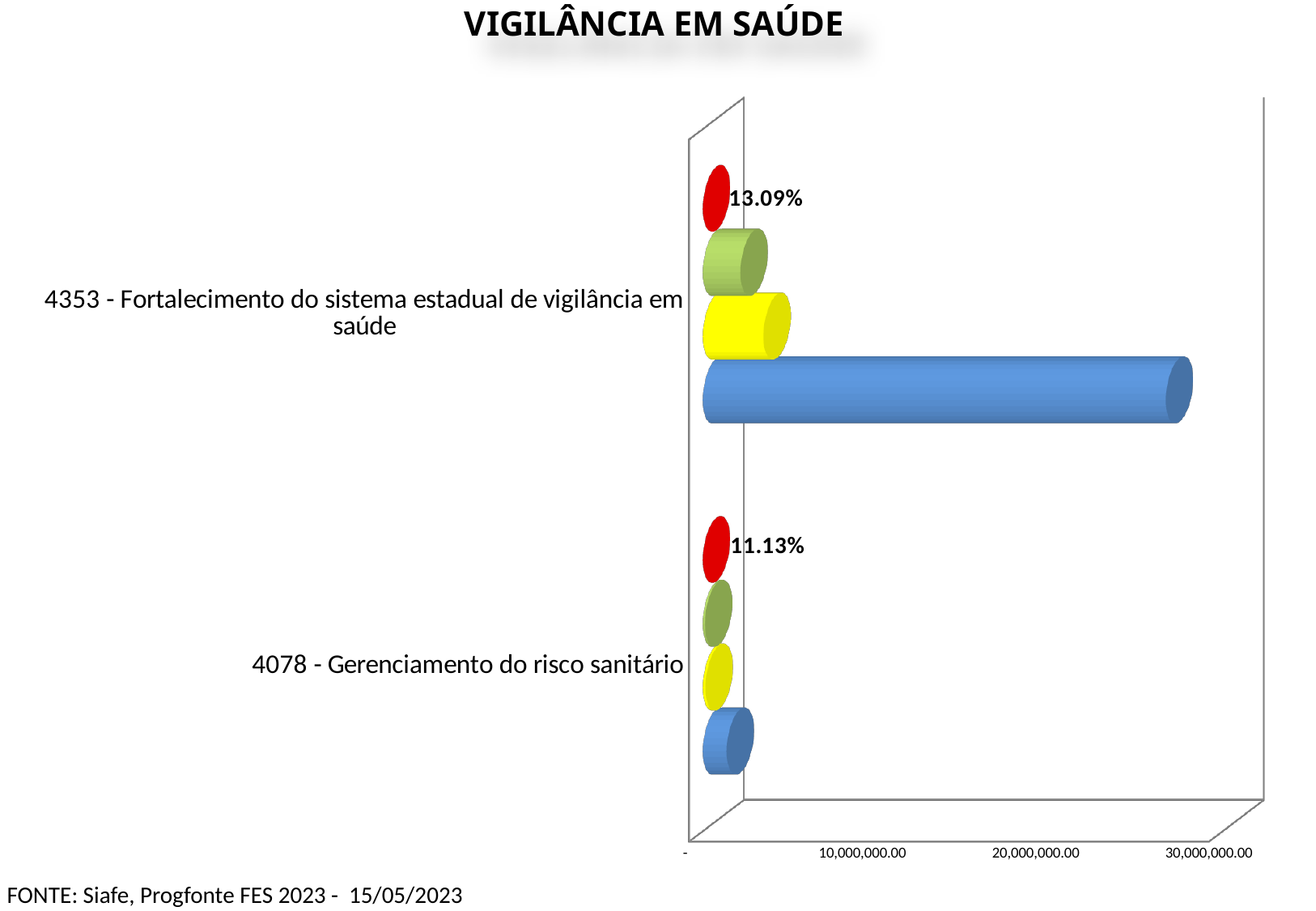
What is the percentage label shown for '4353 - Fortalecimento do sistema estadual de vigilância em saúde'? 13.09% What is the title of the chart? VIGILÂNCIA EM SAÚDE Which category has the longest bar on the chart? 4353 - Fortalecimento do sistema estadual de vigilância em saúde How many categories are shown on the chart? 2 What is the percentage label shown for '4078 - Gerenciamento do risco sanitário'? 11.13% Which category has the larger percentage label, 4353 or 4078? 4353 - Fortalecimento do sistema estadual de vigilância em saúde Is the value of the blue bar for '4353 - Fortalecimento do sistema estadual de vigilância em saúde' greater or less than 30,000,000.00? less Is the value of the blue bar for '4078 - Gerenciamento do risco sanitário' greater or less than 10,000,000.00? less What type of chart is shown on the slide? bar chart What is the difference between the percentage labels for 4353 (13.09%) and 4078 (11.13%)? 1.96% How many bars are plotted for each category? 4 Is the value of the blue bar for '4353 - Fortalecimento do sistema estadual de vigilância em saúde' greater or less than 20,000,000.00? greater